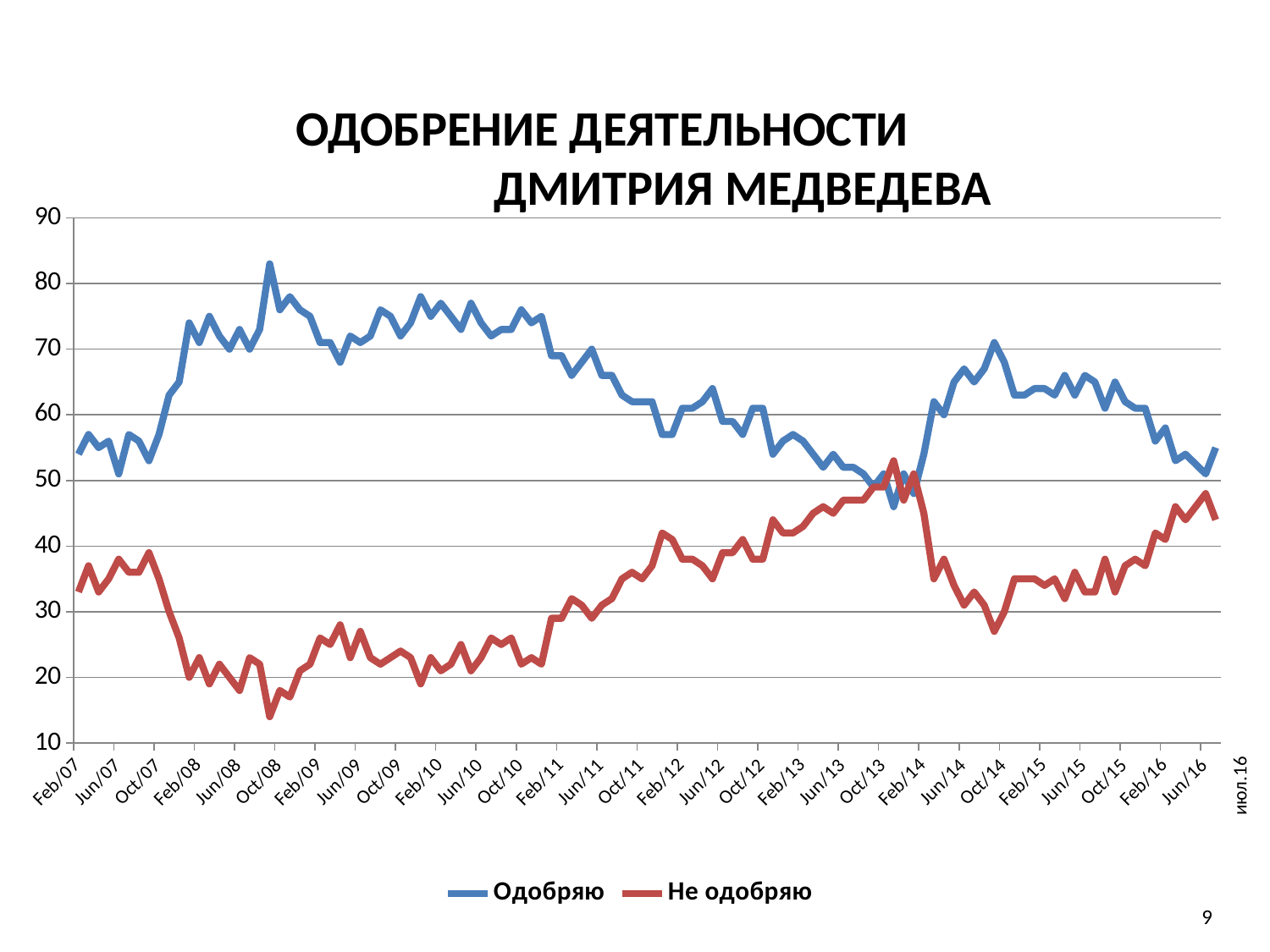
What kind of chart is shown on the slide? line chart Is the value of 'Не одобряю' at Jun/16 greater or less than 50? less Which colour is used for the 'Не одобряю' series? red What is the title of the chart? ОДОБРЕНИЕ ДЕЯТЕЛЬНОСТИ ДМИТРИЯ МЕДВЕДЕВА How many series does the legend list? 2 Is the value of 'Не одобряю' at Oct/14 greater or less than 40? less Is the value of 'Не одобряю' at Oct/08 greater or less than 30? less Does the 'Одобряю' series generally rise or fall between Oct/08 and Oct/13? fall At Feb/07, which series has the higher value, 'Одобряю' or 'Не одобряю'? Одобряю Does the 'Не одобряю' series generally rise or fall between Feb/11 and Oct/13? rise